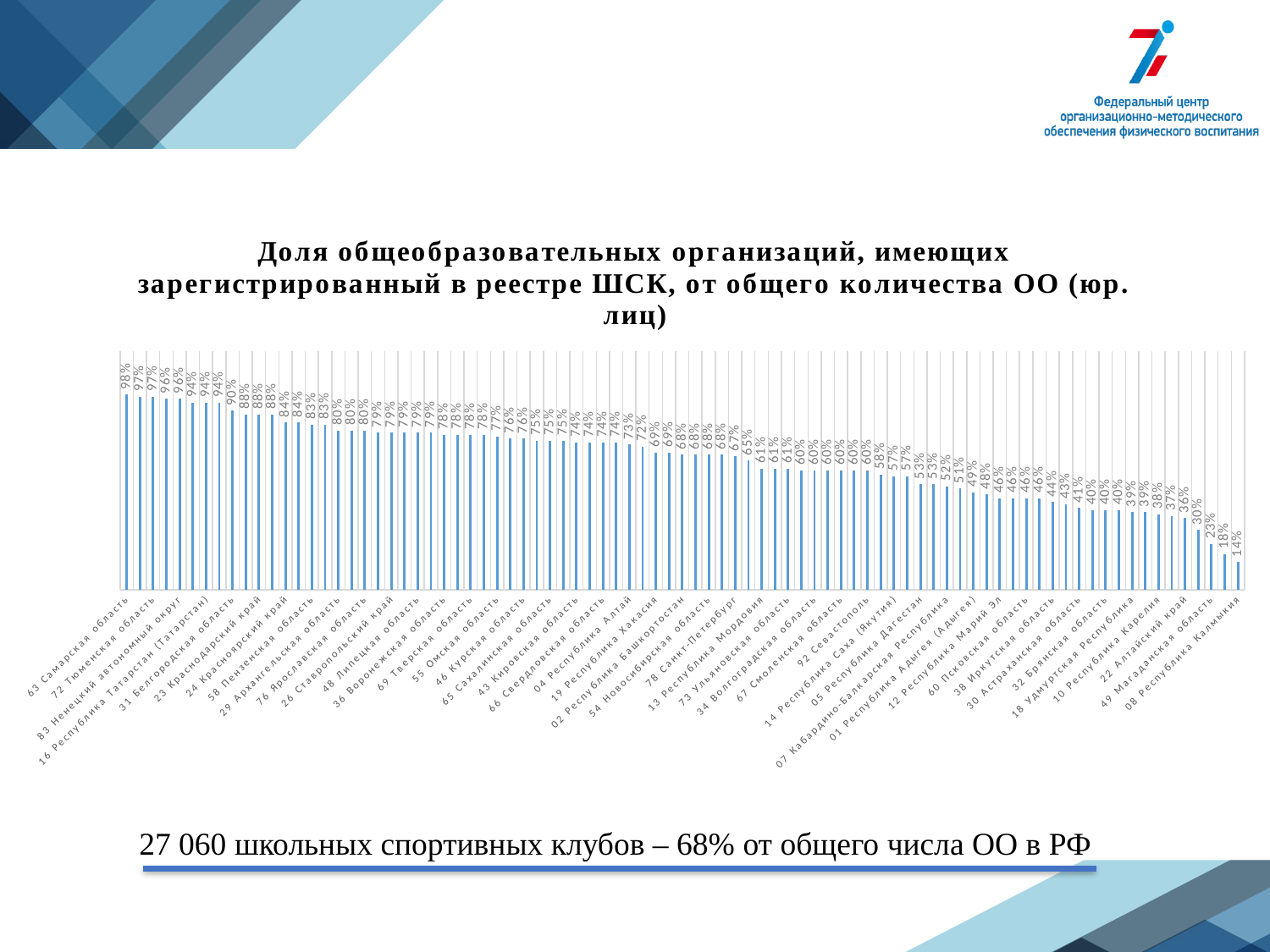
What is the value shown for 72 Тюменская область? 97% Which region has the lowest share of organisations with a registered school sports club? 08 Республика Калмыкия What is the value shown for 63 Самарская область? 98% What is the value shown for 08 Республика Калмыкия? 14% Which has the larger value, 63 Самарская область or 08 Республика Калмыкия? 63 Самарская область What is the title of the chart? Доля общеобразовательных организаций, имеющих зарегистрированный в реестре ШСК, от общего количества ОО (юр. лиц) What is the difference between the values for 63 Самарская область and 08 Республика Калмыкия? 84 percentage points How many data series are plotted in the chart? 1 Do the values rise or fall from left to right along the x axis? Fall What kind of chart is shown on the slide? Bar chart Which region has the highest share of organisations with a registered school sports club? 63 Самарская область What colour are the bars in the chart? Blue